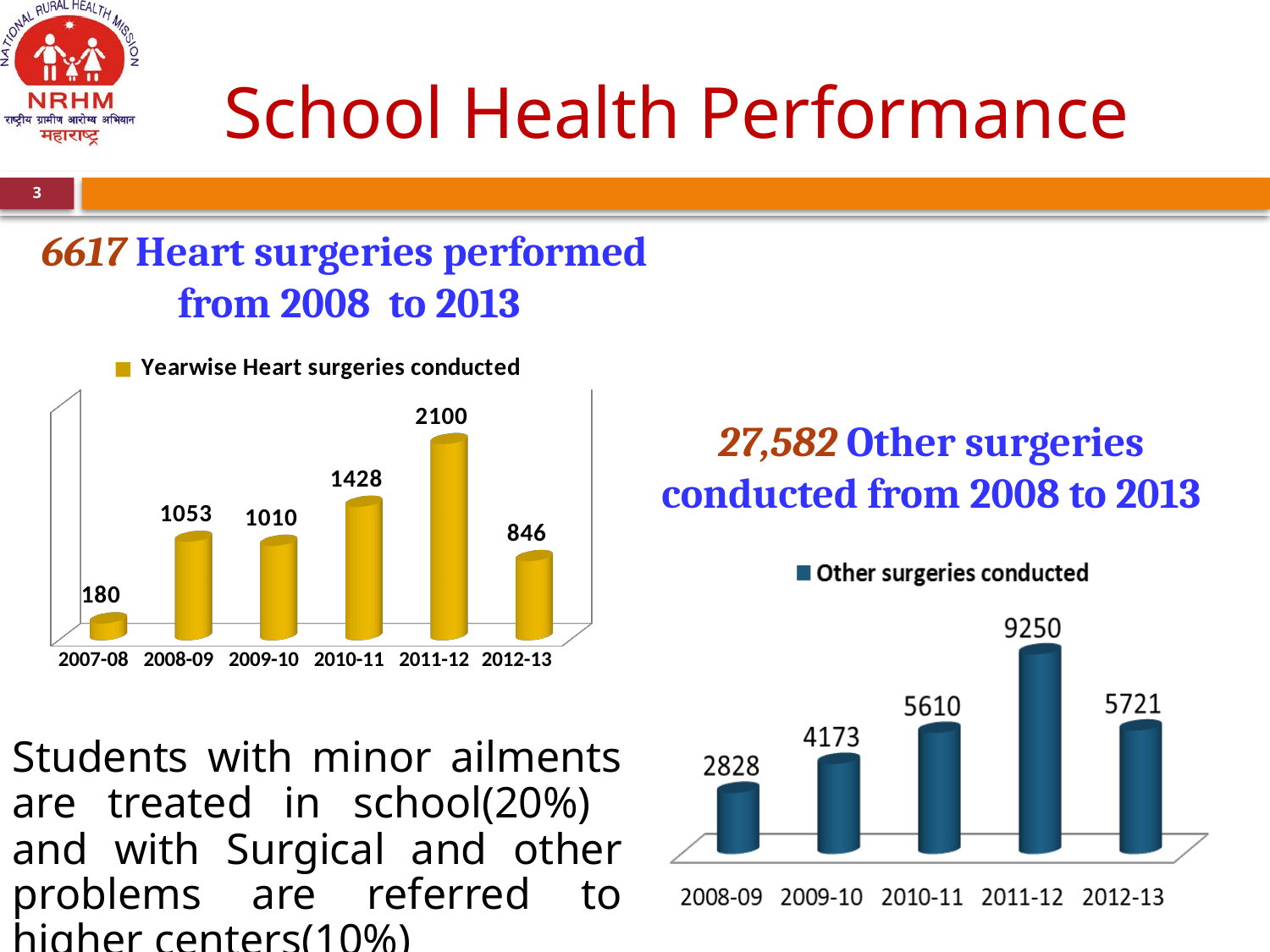
In the 'Yearwise Heart surgeries conducted' chart, what is the value for 2007-08? 180 In the 'Other surgeries conducted' chart, which is larger, the value for 2009-10 or the value for 2012-13? 2012-13 In the 'Yearwise Heart surgeries conducted' chart, what is the difference between the values for 2011-12 and 2012-13? 1254 In the 'Other surgeries conducted' chart, which year has the lowest value? 2008-09 In the 'Yearwise Heart surgeries conducted' chart, which year has the lowest value? 2007-08 In the 'Other surgeries conducted' chart, what is the difference between the values for 2011-12 and 2008-09? 6422 In the 'Yearwise Heart surgeries conducted' chart, how many heart surgeries were conducted in 2011-12? 2100 What type of chart is the 'Other surgeries conducted' chart? Bar chart In the 'Yearwise Heart surgeries conducted' chart, which year has the highest value? 2011-12 In the 'Yearwise Heart surgeries conducted' chart, how many years are shown on the x axis? 6 In the 'Other surgeries conducted' chart, what is the value for 2010-11? 5610 In the 'Other surgeries conducted' chart, which year has the highest value? 2011-12